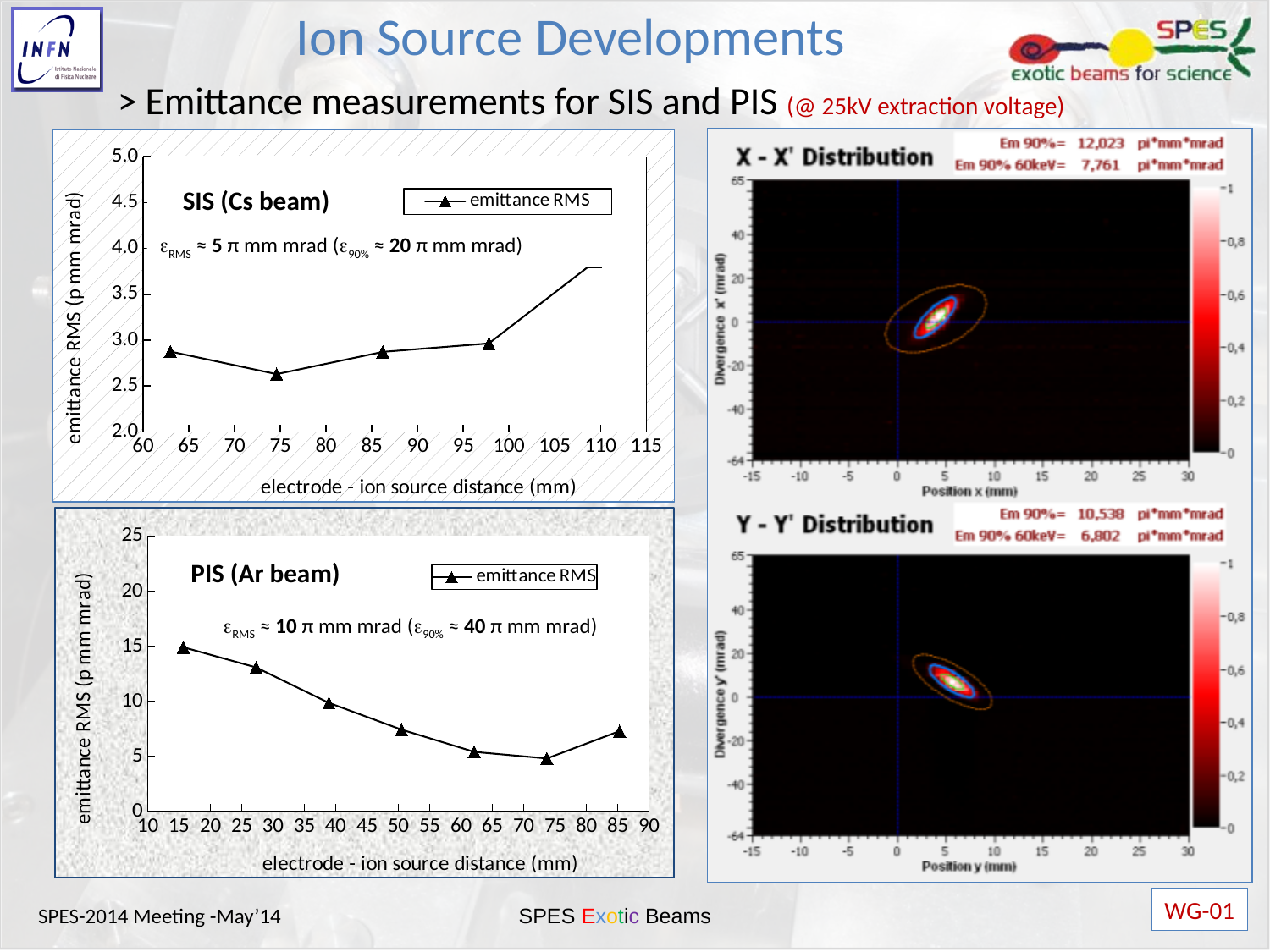
How many data points are plotted in the PIS (Ar beam) chart? 7 How many data points are plotted in the SIS (Cs beam) chart? 5 In the PIS (Ar beam) chart, is the highest emittance RMS value at the smallest or the largest electrode distance? smallest In the PIS (Ar beam) chart, is the emittance RMS at about 50 mm greater or less than 10? less How many series does the legend of the PIS (Ar beam) chart list? 1 What kind of chart is the SIS (Cs beam) chart on the left? line chart In the SIS (Cs beam) chart, does the emittance RMS rise or fall as the electrode distance increases from about 75 mm to about 110 mm? rise In the X - X' Distribution plot, what is the Em 90% value? 12,023 pi*mm*mrad In the SIS (Cs beam) chart, is the emittance RMS at the largest electrode distance (around 110 mm) greater or less than 3.5? greater In the SIS (Cs beam) chart, is the emittance RMS at the smallest electrode distance (around 63 mm) greater or less than 2.5? greater In the PIS (Ar beam) chart, which is larger: the emittance RMS at the smallest electrode distance or at the largest electrode distance? smallest electrode distance